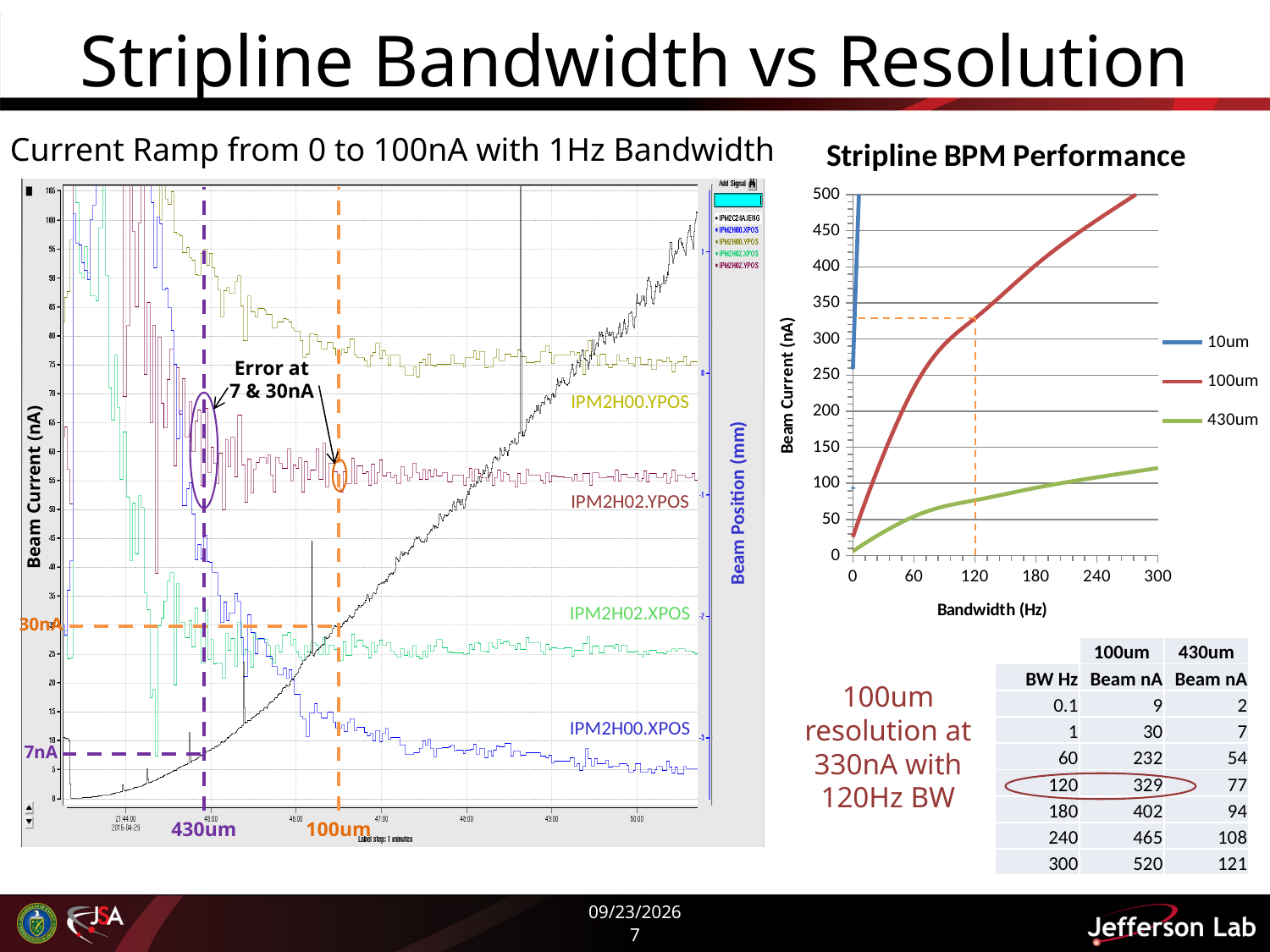
In the Stripline BPM Performance chart, does the beam current for the 100um series rise or fall as bandwidth increases? rise In the Stripline BPM Performance chart, which series reaches the highest beam current at 300 Hz bandwidth, 100um or 430um? 100um In the Stripline BPM Performance chart, is the beam current for the 100um series at 240 Hz greater or less than 400 nA? greater In the Stripline BPM Performance chart, what is the label of the x axis? Bandwidth (Hz) In the Current Ramp chart on the left, what is the label of the left y axis? Beam Current (nA) According to the table next to the Stripline BPM Performance chart, what is the beam current for 100um resolution at 120 Hz bandwidth? 329 In the Stripline BPM Performance chart, is the beam current for the 430um series at 300 Hz greater or less than 150 nA? less What kind of chart is the Stripline BPM Performance chart? line chart In the Current Ramp chart on the left, how many signals does the legend list? 5 According to the table next to the Stripline BPM Performance chart, what is the difference between the 100um and 430um beam currents at 300 Hz bandwidth? 399 In the Stripline BPM Performance chart, how many series does the legend list? 3 According to the table next to the Stripline BPM Performance chart, what is the beam current for 430um resolution at 60 Hz bandwidth? 54